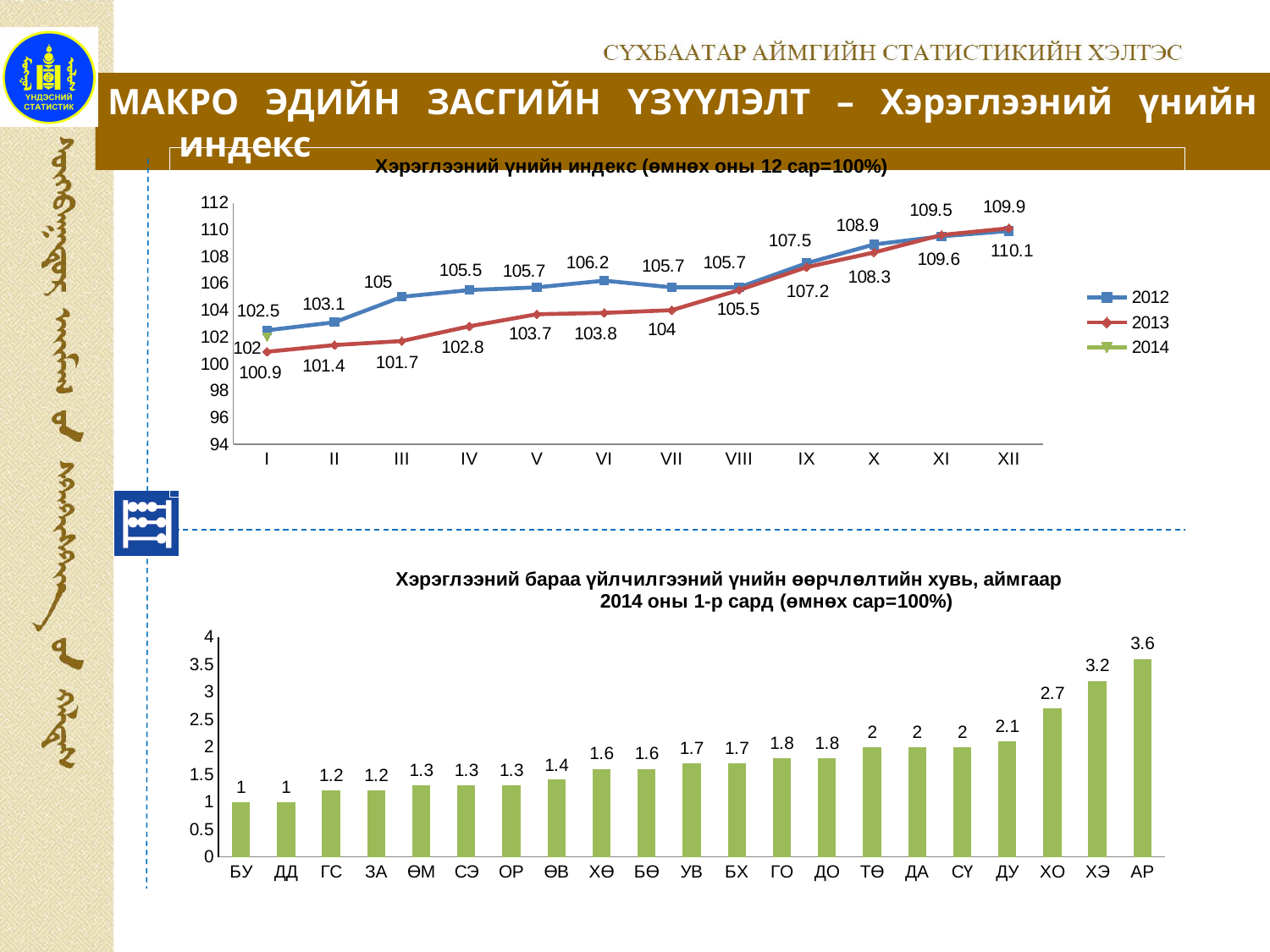
In the bottom chart (Хэрэглээний бараа үйлчилгээний үнийн өөрчлөлтийн хувь, аймгаар), what is the value for ХО? 2.7 In the bottom chart (Хэрэглээний бараа үйлчилгээний үнийн өөрчлөлтийн хувь, аймгаар), which category has the highest value? АР In the bottom chart (Хэрэглээний бараа үйлчилгээний үнийн өөрчлөлтийн хувь, аймгаар), how many categories are shown on the x axis? 21 What kind of chart is the bottom chart (Хэрэглээний бараа үйлчилгээний үнийн өөрчлөлтийн хувь, аймгаар)? bar chart In the top chart (Хэрэглээний үнийн индекс), which is larger for month IV: the 2012 value or the 2013 value? 2012 In the bottom chart (Хэрэглээний бараа үйлчилгээний үнийн өөрчлөлтийн хувь, аймгаар), what is the difference between the values for ХЭ and ДУ? 1.1 In the top chart (Хэрэглээний үнийн индекс), what is the 2012 value for month VI? 106.2 In the top chart (Хэрэглээний үнийн индекс), what is the difference between the 2012 and 2013 values for month III? 3.3 In the top chart (Хэрэглээний үнийн индекс), how many series does the legend list? 3 In the top chart (Хэрэглээний үнийн индекс), what is the 2014 value for month I? 102 In the top chart (Хэрэглээний үнийн индекс), does the 2013 series rise or fall from month I to month XII? rise In the top chart (Хэрэглээний үнийн индекс), what is the 2013 value for month XII? 110.1